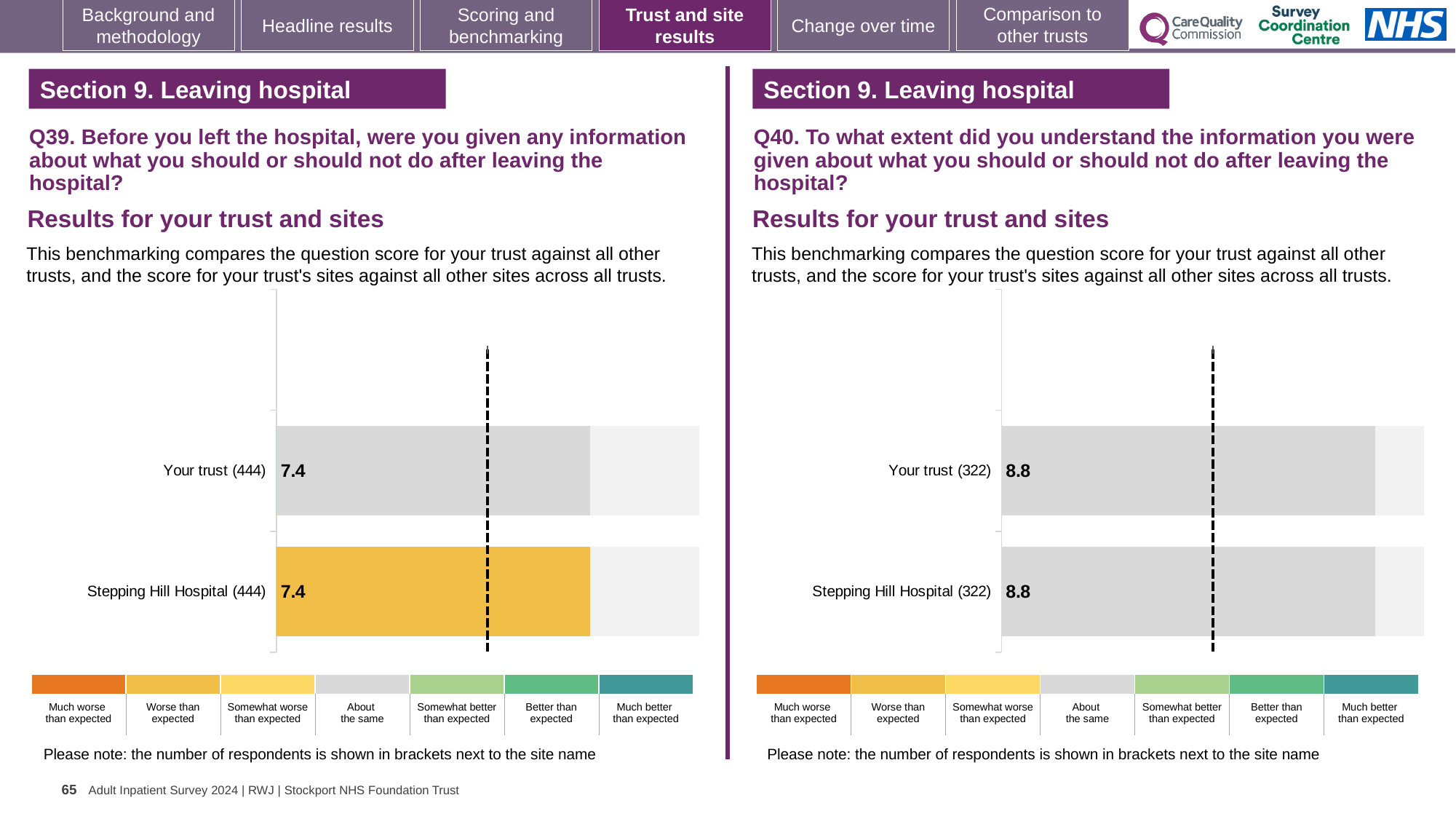
How many bars are plotted in the Q40 chart on the right? 2 In the Q40 chart on the right, what is the score for Stepping Hill Hospital? 8.8 In the Q39 chart on the left, what is the difference between the score for Your trust and the score for Stepping Hill Hospital? 0 In the Q40 chart on the right, what is the difference between the score for Your trust and the score for Stepping Hill Hospital? 0 In the Q39 chart on the left, how many respondents are shown in brackets next to Stepping Hill Hospital? 444 In the Q39 chart on the left, which benchmark category does the colour of the Stepping Hill Hospital bar correspond to in the key? Worse than expected In the Q39 chart on the left, what is the score for Your trust? 7.4 In the Q40 chart on the right, how many respondents are shown in brackets next to Your trust? 322 In the Q39 chart on the left, what is the score for Stepping Hill Hospital? 7.4 In the Q40 chart on the right, what is the score for Your trust? 8.8 What kind of chart is used for the Q39 results on the left? Bar chart How many bars are plotted in the Q39 chart on the left? 2